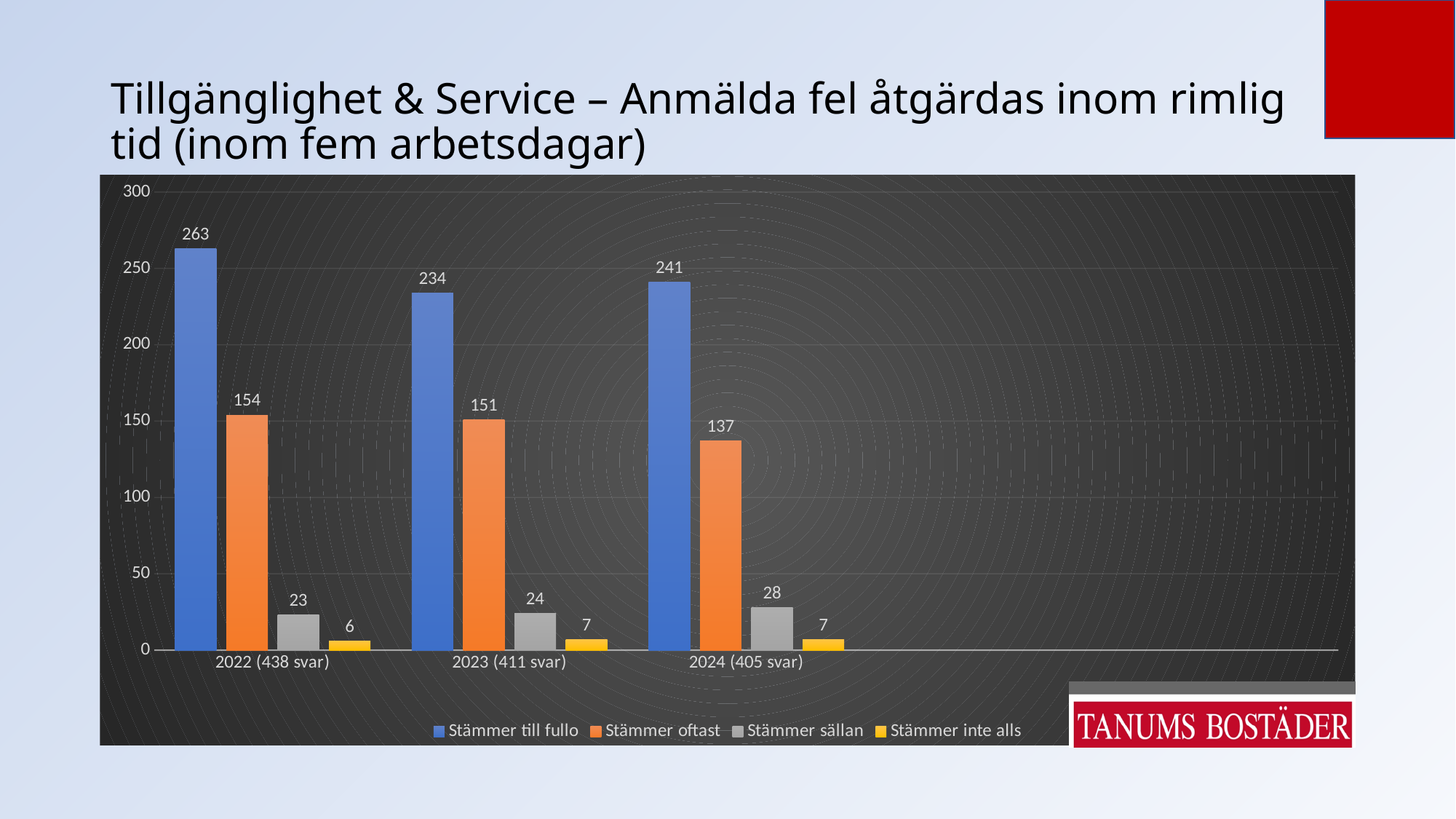
Which is larger: "Stämmer sällan" in 2024 (405 svar) or "Stämmer sällan" in 2022 (438 svar)? 2024 (405 svar) How many year categories are shown on the x axis? 3 In which year is the value for "Stämmer till fullo" highest? 2022 (438 svar) How many series does the legend list? 4 What is the value for "Stämmer oftast" in 2024 (405 svar)? 137 In which year is the value for "Stämmer oftast" lowest? 2024 (405 svar) What is the value for "Stämmer till fullo" in 2022 (438 svar)? 263 What is the value for "Stämmer sällan" in 2023 (411 svar)? 24 What is the value for "Stämmer inte alls" in 2022 (438 svar)? 6 What is the difference between the "Stämmer till fullo" values for 2022 (438 svar) and 2024 (405 svar)? 22 What kind of chart is shown on the slide? Bar chart Does the value for "Stämmer oftast" rise or fall from 2022 to 2024? Fall